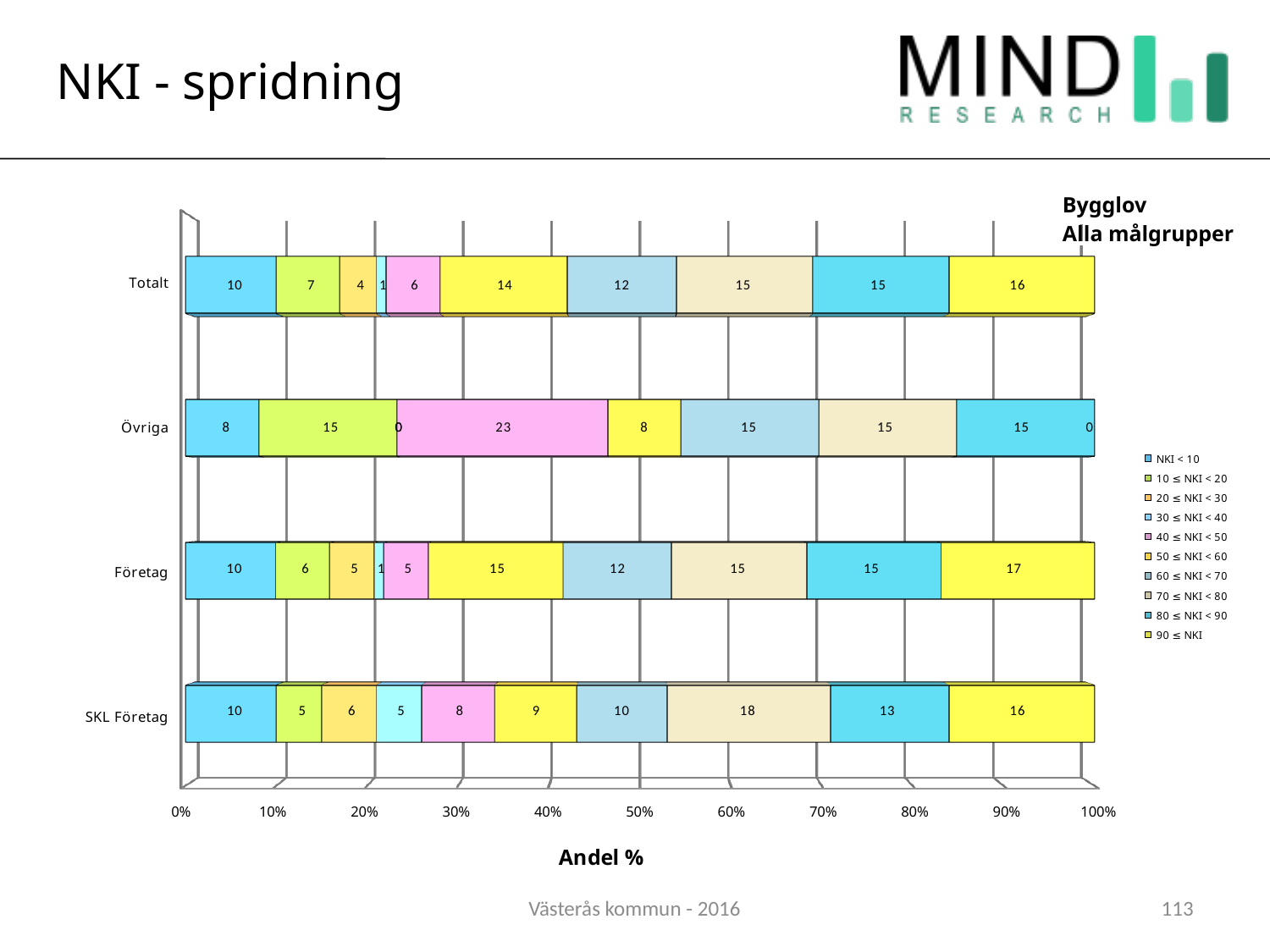
How many categories (bars) are shown on the y axis of the chart? 4 What is the value for the NKI < 10 segment in the Totalt bar? 10 What type of chart is shown on the slide? Stacked bar chart What is the difference between the 90 ≤ NKI value for Företag and the 90 ≤ NKI value for Totalt? 1 What is the title of the x axis of the chart? Andel % What is the value for the 40 ≤ NKI < 50 segment in the Övriga bar? 23 What is the value for the 70 ≤ NKI < 80 segment in the SKL Företag bar? 18 What is the value for the 90 ≤ NKI segment in the Totalt bar? 16 Which category has the largest 40 ≤ NKI < 50 segment? Övriga What is the value for the 90 ≤ NKI segment in the Företag bar? 17 Which is larger: the 70 ≤ NKI < 80 value for SKL Företag or for Företag? SKL Företag How many series does the chart legend list? 10